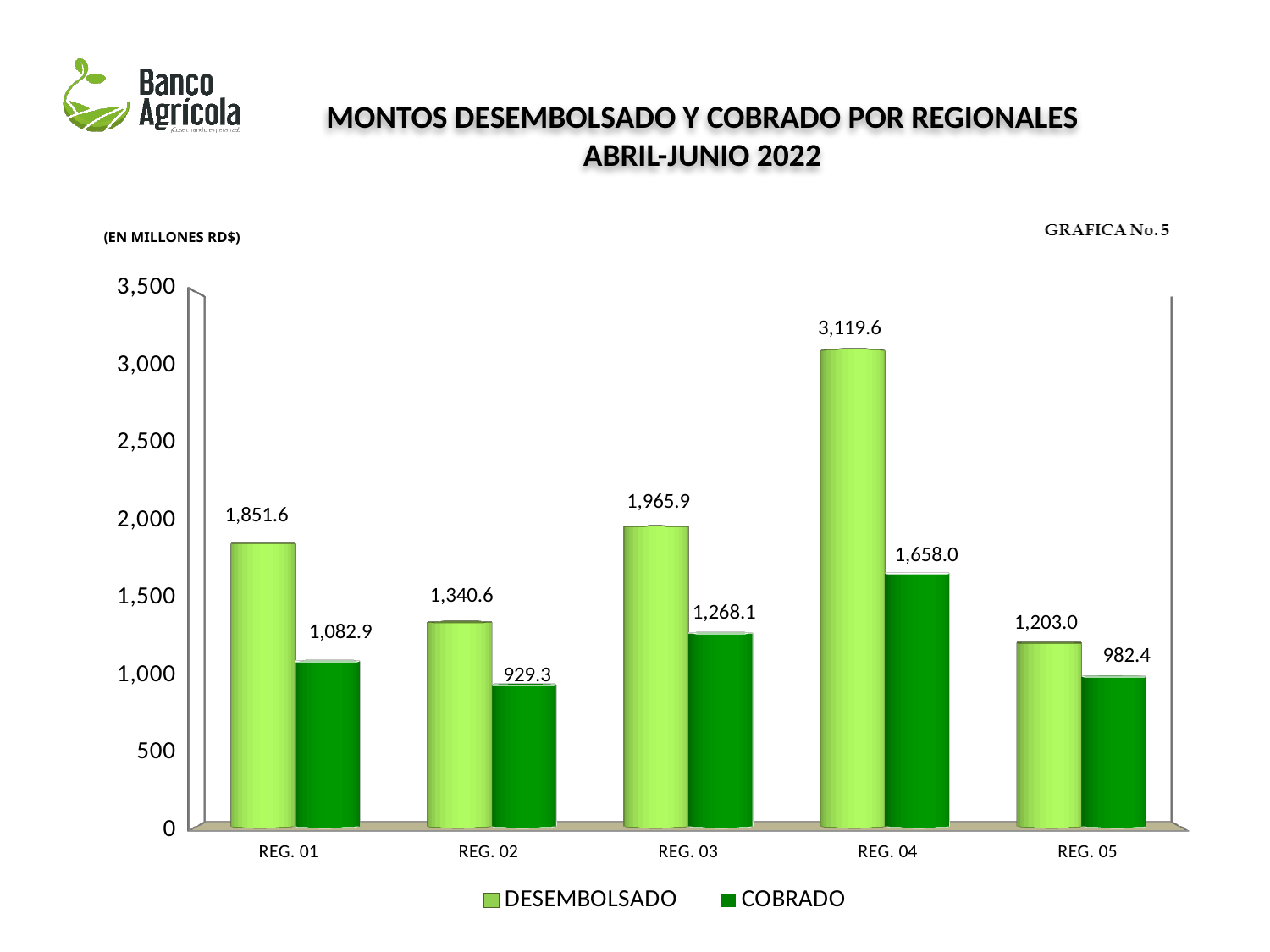
Which is larger, the DESEMBOLSADO value for REG. 03 or the DESEMBOLSADO value for REG. 01? REG. 03 What is the COBRADO value for REG. 02? 929.3 What is the difference between DESEMBOLSADO and COBRADO for REG. 01? 768.7 What kind of chart is shown on the slide? Bar chart What unit is stated for the values in the chart? EN MILLONES RD$ How many regions are shown on the x axis? 5 What is the DESEMBOLSADO value for REG. 04? 3,119.6 Which region has the lowest COBRADO value? REG. 02 Which region has the highest DESEMBOLSADO value? REG. 04 How many series does the legend list? 2 Is the COBRADO value for REG. 04 greater or less than 1,500? greater What is the COBRADO value for REG. 05? 982.4